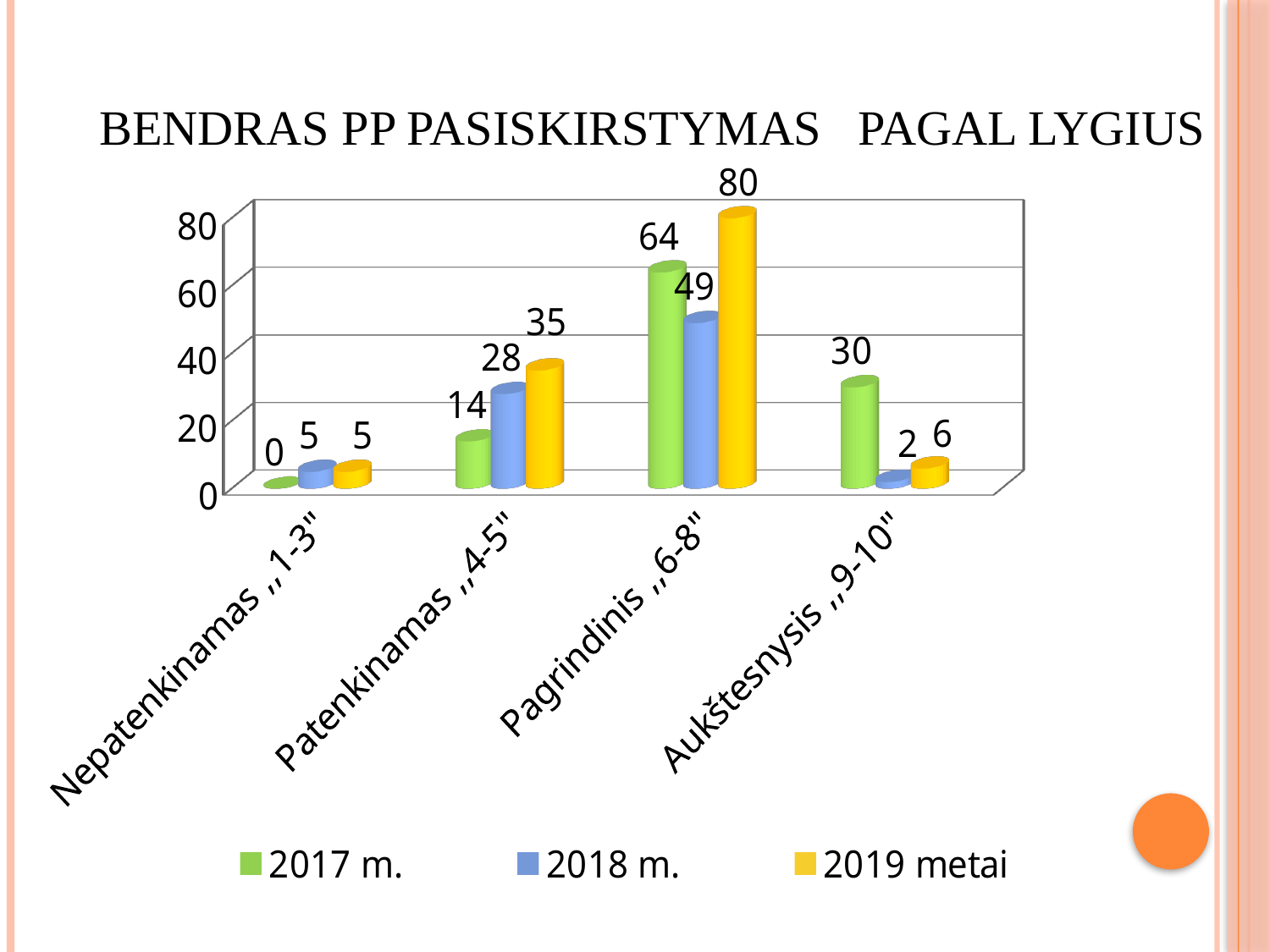
Which category has the highest value for the 2018 m. series? Pagrindinis „6-8" What is the value for 2018 m. in the Patenkinamas „4-5" category? 28 What is the title of the chart? BENDRAS PP PASISKIRSTYMAS PAGAL LYGIUS How many series does the legend list? 3 In the Aukštesnysis „9-10" category, which series has the larger value: 2017 m. or 2019 metai? 2017 m. What is the difference between the 2019 metai and 2017 m. values in the Pagrindinis „6-8" category? 16 How many categories are shown on the x axis? 4 What is the value for 2019 metai in the Pagrindinis „6-8" category? 80 What is the value for 2017 m. in the Aukštesnysis „9-10" category? 30 Which category has the lowest value for the 2019 metai series? Nepatenkinamas „1-3" What kind of chart is shown on the slide? Bar chart What is the value for 2017 m. in the Nepatenkinamas „1-3" category? 0